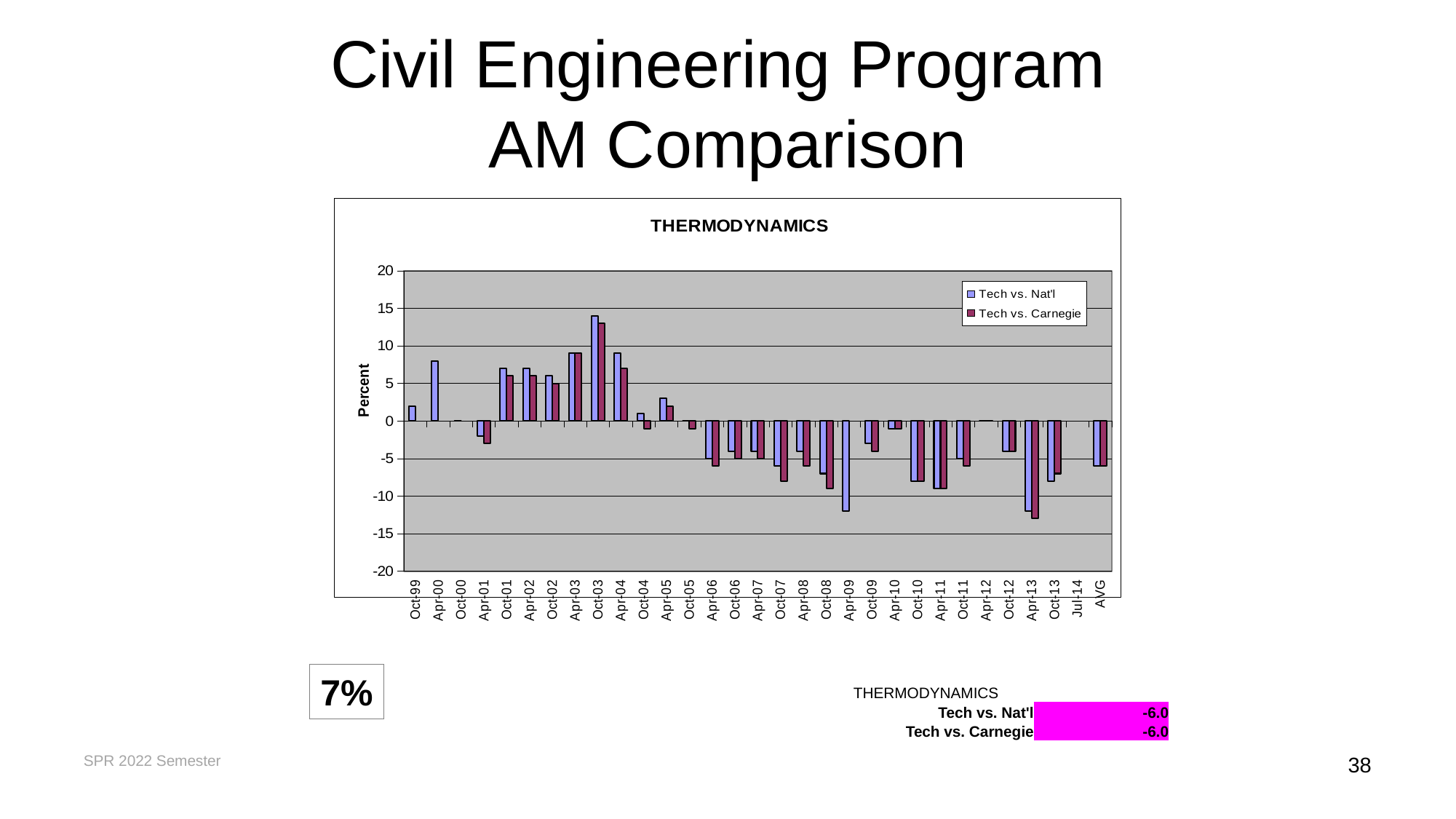
In which period does the Tech vs. Carnegie series reach its lowest value? Apr-13 What are the two series named in the legend of the THERMODYNAMICS chart? Tech vs. Nat'l and Tech vs. Carnegie What is the label on the vertical axis of the THERMODYNAMICS chart? Percent What kind of chart is shown under the title THERMODYNAMICS? bar chart For the Tech vs. Nat'l series, which is larger: the value for Oct-03 or the value for Apr-04? Oct-03 According to the table below the chart, what is the AVG value for Tech vs. Carnegie? -6.0 Is the Tech vs. Carnegie value for Apr-13 greater or less than -10? less According to the table below the chart, what is the AVG value for Tech vs. Nat'l? -6.0 How many categories are shown along the x axis of the THERMODYNAMICS chart, including AVG? 31 Is the Tech vs. Nat'l value for Oct-03 greater or less than 10? greater In which period does the Tech vs. Nat'l series reach its highest value? Oct-03 How many series does the legend of the THERMODYNAMICS chart list? 2